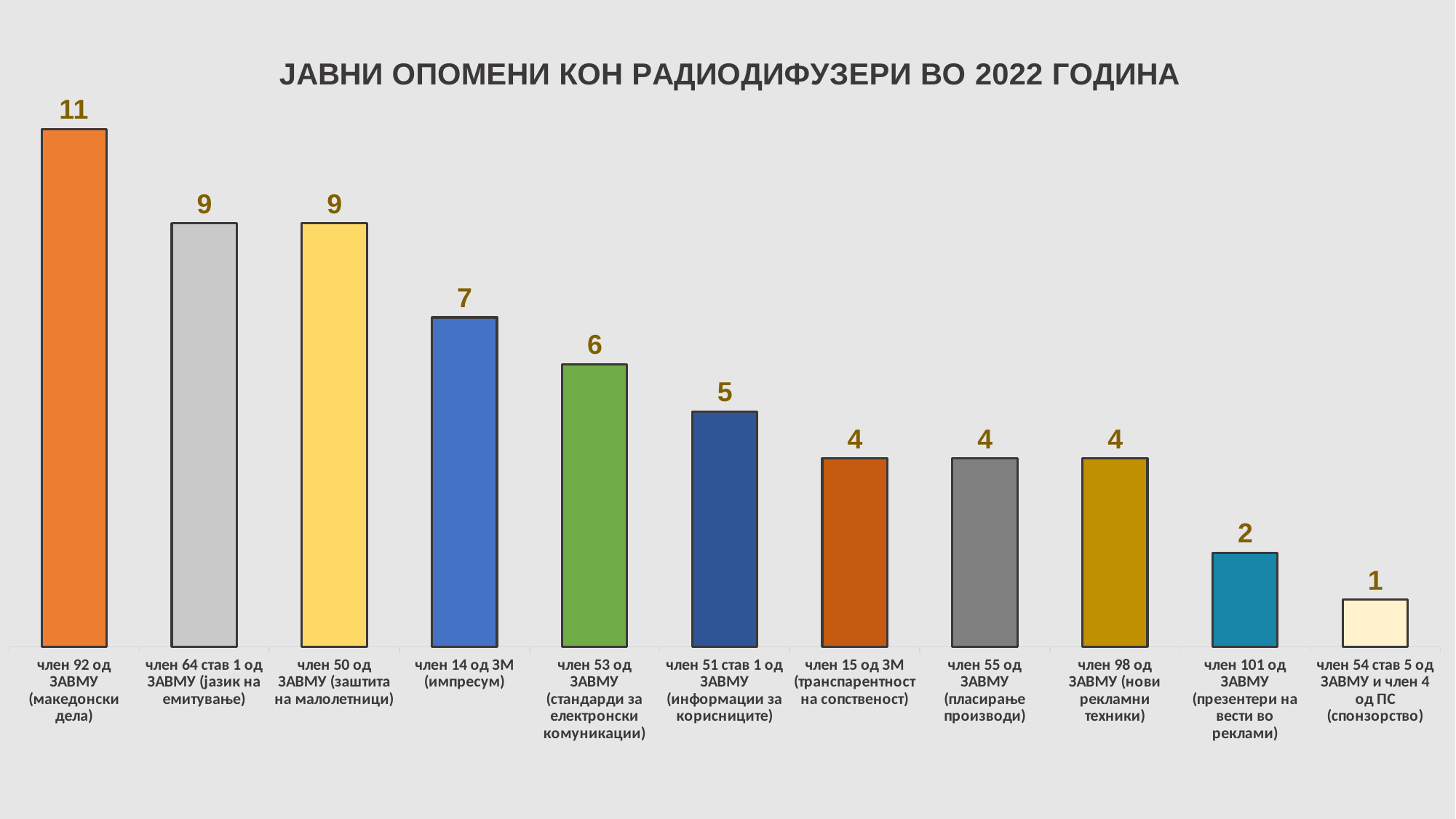
Which category has the highest value? член 92 од ЗАВМУ (македонски дела) What kind of chart is shown on the slide? bar chart Which is larger, the value for член 51 став 1 од ЗАВМУ (информации за корисниците) or the value for член 15 од ЗМ (транспарентност на сопственост)? член 51 став 1 од ЗАВМУ (информации за корисниците) What is the difference between the values for член 92 од ЗАВМУ (македонски дела) and член 50 од ЗАВМУ (заштита на малолетници)? 2 Which category has the lowest value? член 54 став 5 од ЗАВМУ и член 4 од ПС (спонзорство) What is the value for член 14 од ЗМ (импресум)? 7 What is the title of the chart? ЈАВНИ ОПОМЕНИ КОН РАДИОДИФУЗЕРИ ВО 2022 ГОДИНА What is the value for член 92 од ЗАВМУ (македонски дела)? 11 How many categories are shown in the chart? 11 Do the values rise or fall from left to right along the x axis? fall What is the value for член 101 од ЗАВМУ (презентери на вести во реклами)? 2 What is the value for член 53 од ЗАВМУ (стандарди за електронски комуникации)? 6